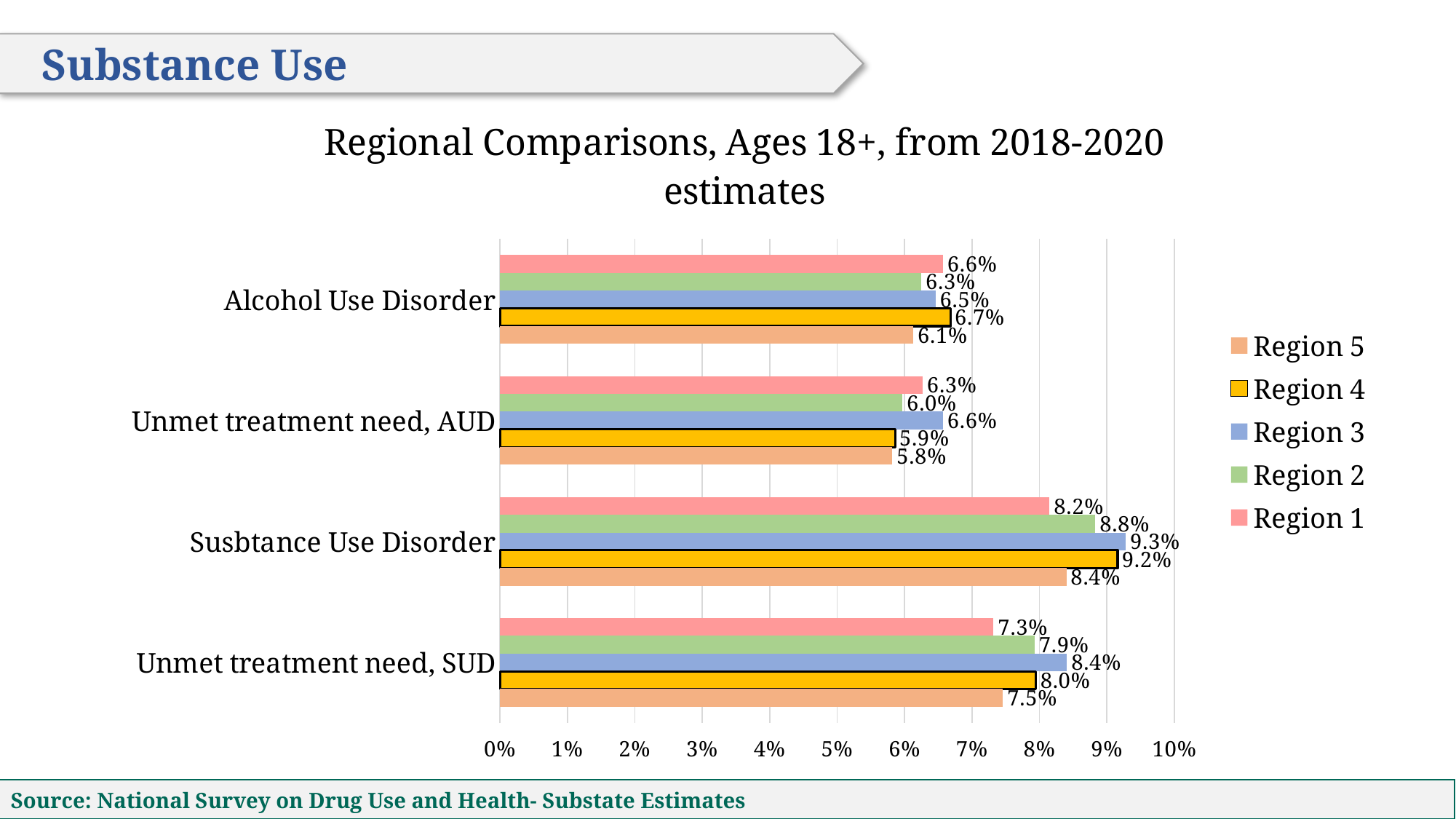
How many categories are shown on the y axis of the chart? 4 Which is larger for Alcohol Use Disorder: Region 4 or Region 2? Region 4 What kind of chart is shown on the slide? Bar chart Which region has the highest value for Susbtance Use Disorder? Region 3 Is the value for Region 2 in the Susbtance Use Disorder category greater or less than 8%? greater What is the value for Region 4 in the Unmet treatment need, AUD category? 5.9% What is the difference between Region 3 and Region 1 for Unmet treatment need, SUD? 1.1% Which region has the lowest value for Unmet treatment need, AUD? Region 5 What is the value for Region 5 in the Alcohol Use Disorder category? 6.1% How many series does the legend list? 5 What is the value for Region 1 in the Unmet treatment need, SUD category? 7.3% What is the value for Region 3 in the Susbtance Use Disorder category? 9.3%